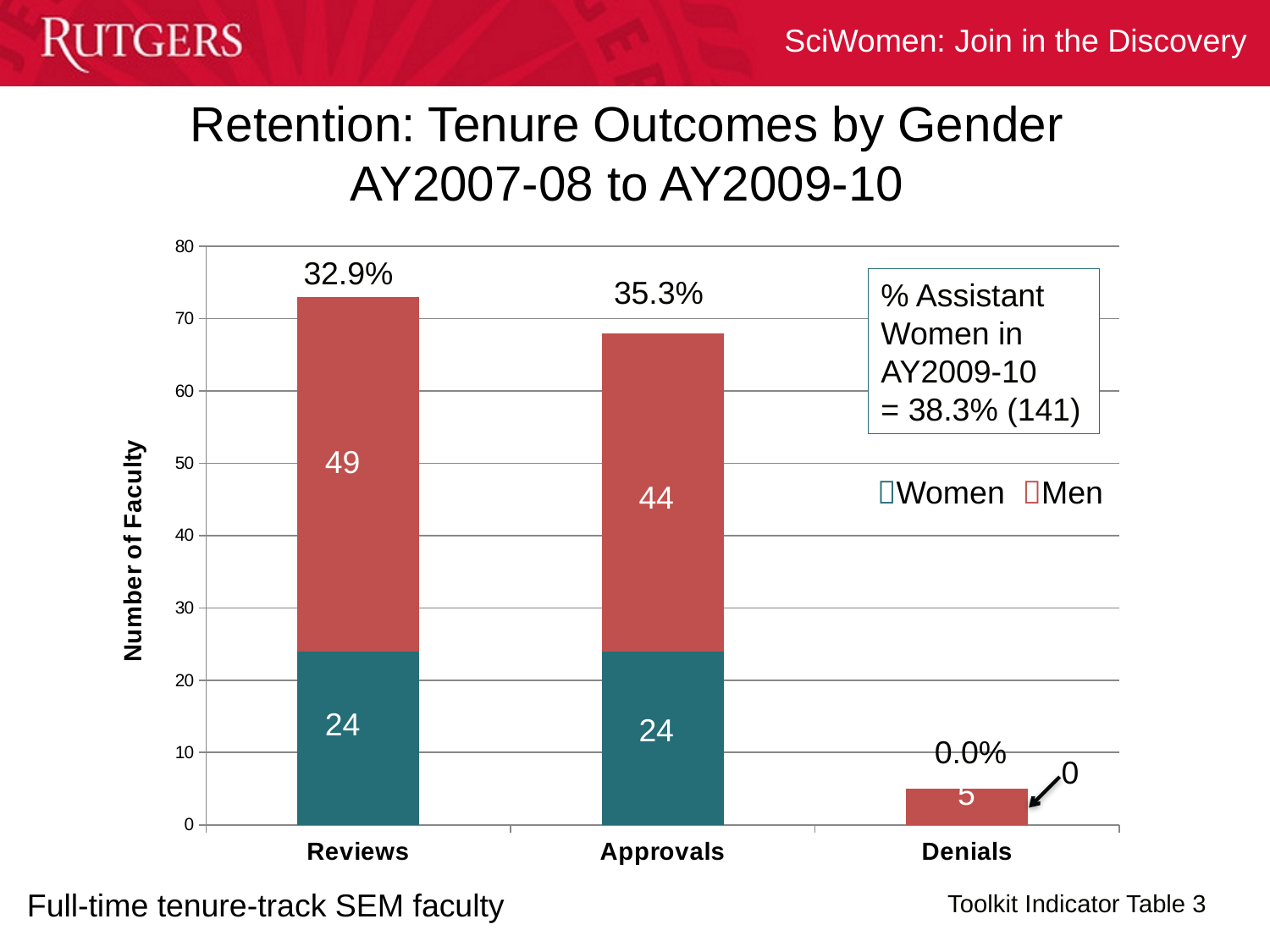
What type of chart is shown on the slide? Stacked bar chart What is the difference between the number of Men and Women for Reviews? 25 What is the number of Men for Denials? 5 What is the label of the y axis? Number of Faculty What is the number of Women for Approvals? 24 How many categories are shown on the x axis of the chart? 3 What is the number of Men for Reviews? 49 What is the total number of faculty for the Reviews bar? 73 What percentage is labelled above the Approvals bar? 35.3% What is the total number of faculty for the Approvals bar? 68 How many series does the chart legend list? 2 Which category has the lowest total number of faculty? Denials